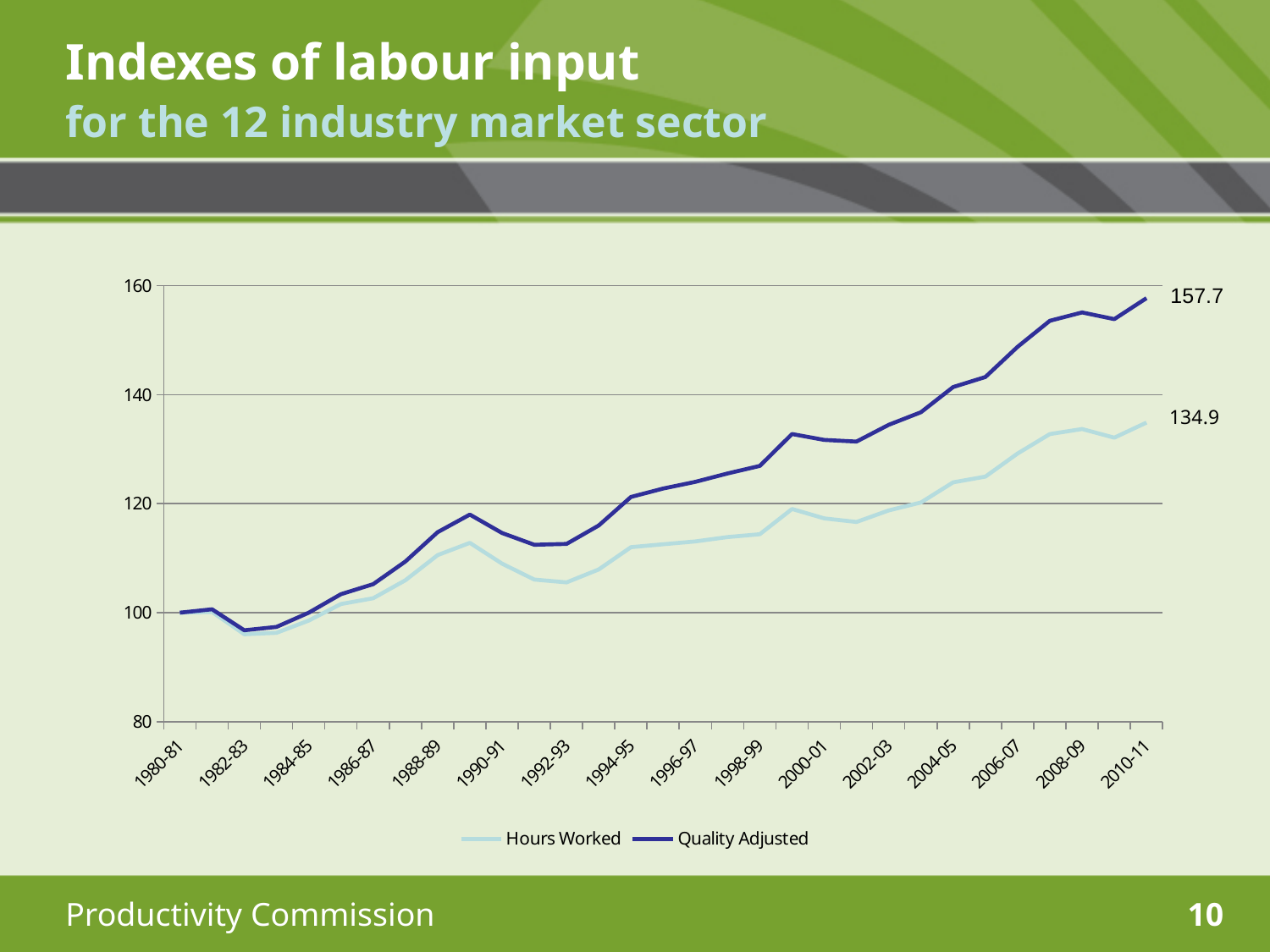
Is the value for Hours Worked in 2006-07 greater or less than 120? greater Is the value for Quality Adjusted in 2000-01 greater or less than 120? greater What kind of chart is shown on the slide? Line chart How many series does the legend list? 2 What are the two series named in the legend? Hours Worked and Quality Adjusted What is the value of the Quality Adjusted index in 2010-11? 157.7 What is the value of the Hours Worked index in 2010-11? 134.9 What is the difference between the Quality Adjusted and Hours Worked indexes in 2010-11? 22.8 Is the value for Quality Adjusted in 1990-91 greater or less than 120? less Which series has the higher value in 2010-11, Hours Worked or Quality Adjusted? Quality Adjusted Do the index values generally rise or fall from 1980-81 to 2010-11? Rise